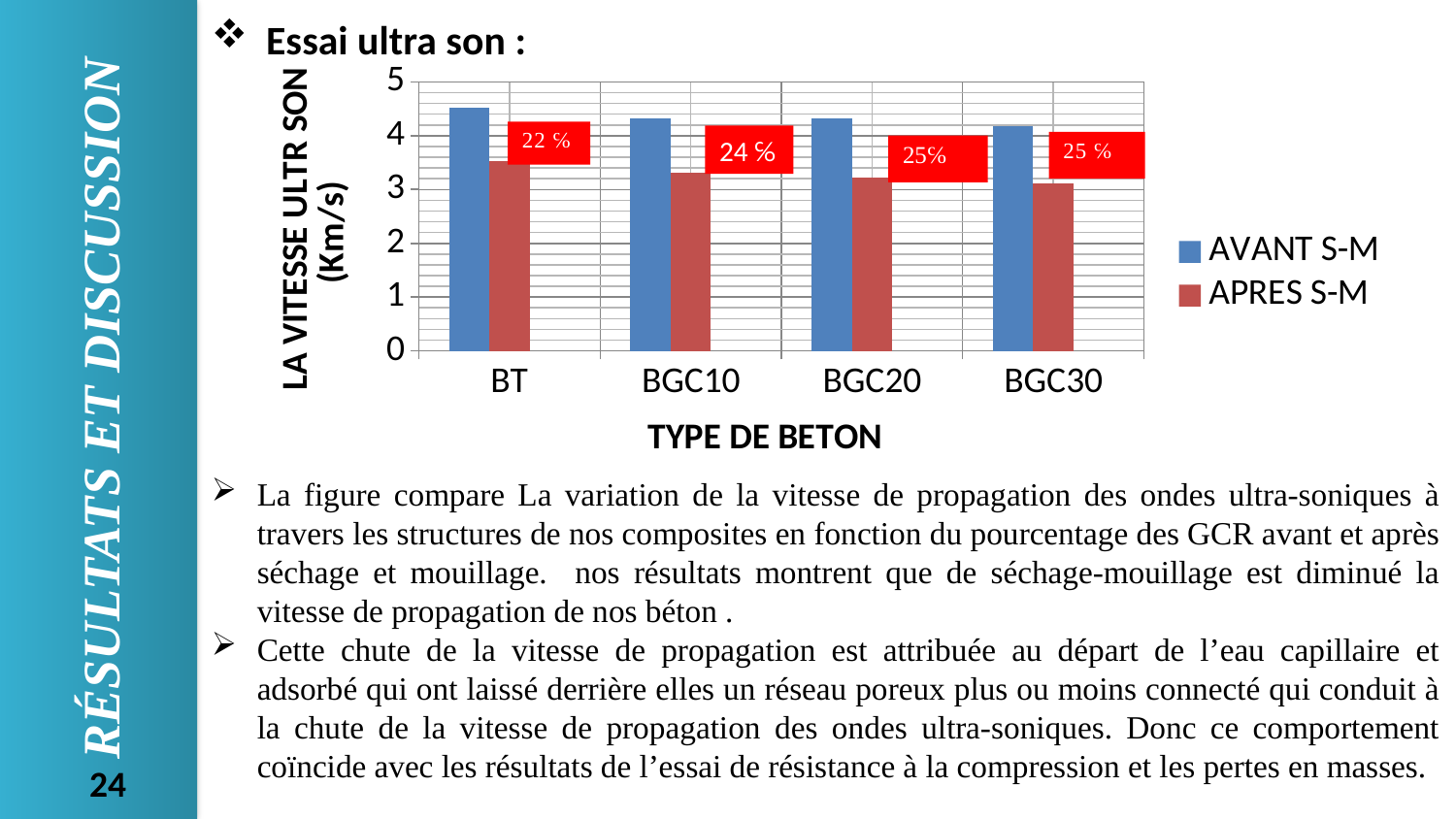
How many concrete types are shown on the x axis? 4 Is the APRES S-M value for BGC30 greater or less than 4? less Do the APRES S-M values rise or fall from BT to BGC30? fall Which series has the higher value for BT, AVANT S-M or APRES S-M? AVANT S-M Is the APRES S-M value for BGC20 greater or less than 3? greater Which concrete type has the highest AVANT S-M value? BT What is the title of the x axis? TYPE DE BETON How many series does the legend list? 2 What kind of chart is shown on the slide? bar chart What percentage is shown in the red label above the BGC10 bars? 24 % Which concrete type has the lowest APRES S-M value? BGC30 Is the AVANT S-M value for BT greater or less than 4? greater